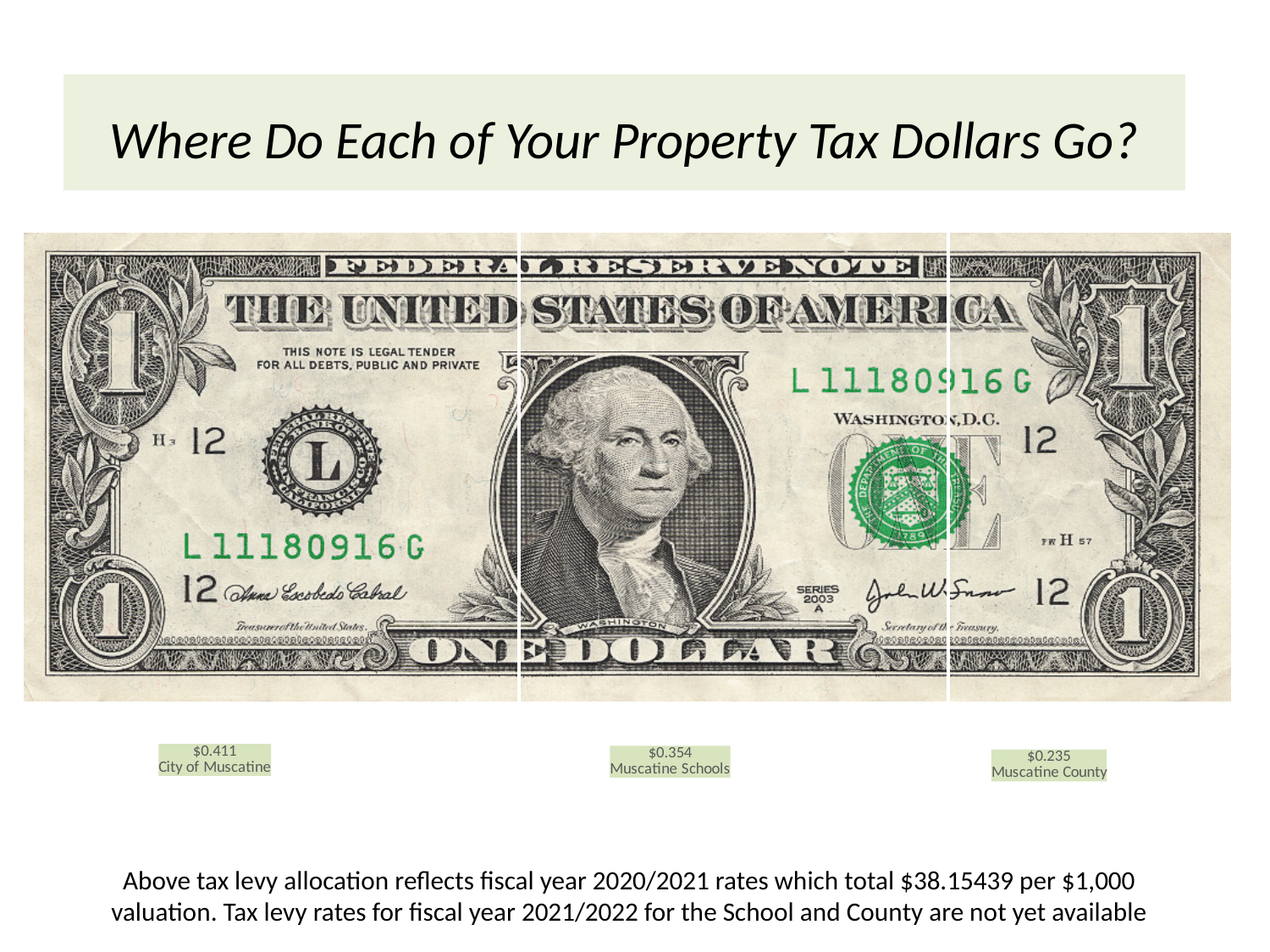
What is the difference between the City of Muscatine share and the Muscatine Schools share of each property tax dollar? $0.057 What share of each property tax dollar goes to Muscatine County? $0.235 How much more of each property tax dollar goes to Muscatine Schools than to Muscatine County? $0.119 How many recipients of property tax dollars are shown on the slide? 3 Which recipient receives the largest share of each property tax dollar? City of Muscatine Which recipient receives the smallest share of each property tax dollar? Muscatine County What is the title of the slide? Where Do Each of Your Property Tax Dollars Go? How much more of each property tax dollar goes to the City of Muscatine than to Muscatine County? $0.176 What share of each property tax dollar goes to Muscatine Schools? $0.354 What is the total of the three shares shown on the slide? $1.000 Which receives a larger share of each property tax dollar, Muscatine Schools or Muscatine County? Muscatine Schools What share of each property tax dollar goes to the City of Muscatine? $0.411